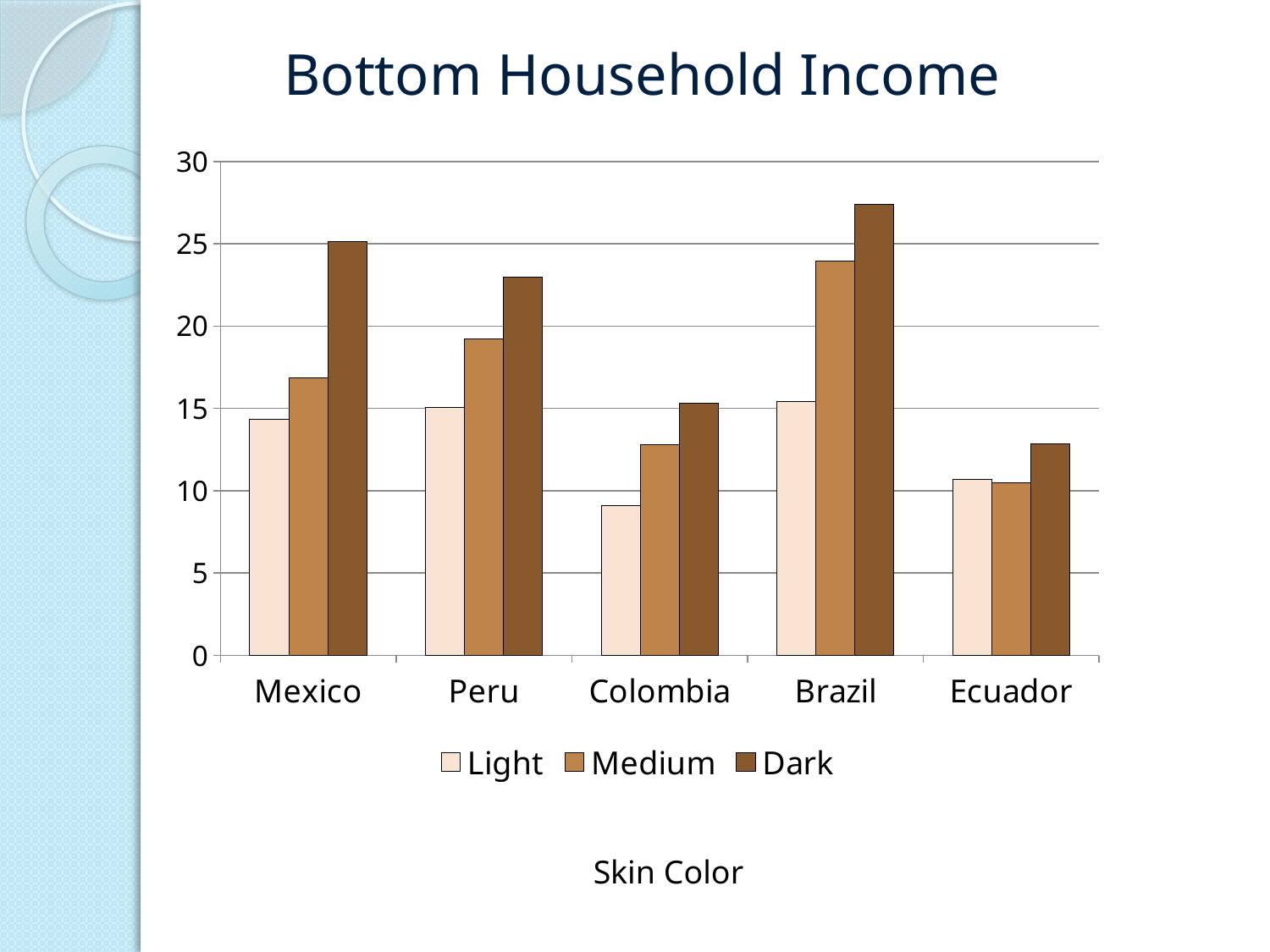
Is the Light value for Colombia greater or less than 10? less Which country has the highest Dark bar? Brazil How many series does the legend list? 3 Is the Medium value for Brazil greater or less than 20? greater Which country has the lowest Light bar? Colombia What kind of chart is shown on the slide? bar chart Which country has the lowest Dark bar? Ecuador Which is larger, the Dark value for Mexico or the Dark value for Peru? Mexico Is the Dark value for Brazil greater or less than 25? greater Which is larger, the Light value for Brazil or the Light value for Colombia? Brazil How many countries are shown on the x axis of the chart? 5 What is the title of the chart? Bottom Household Income